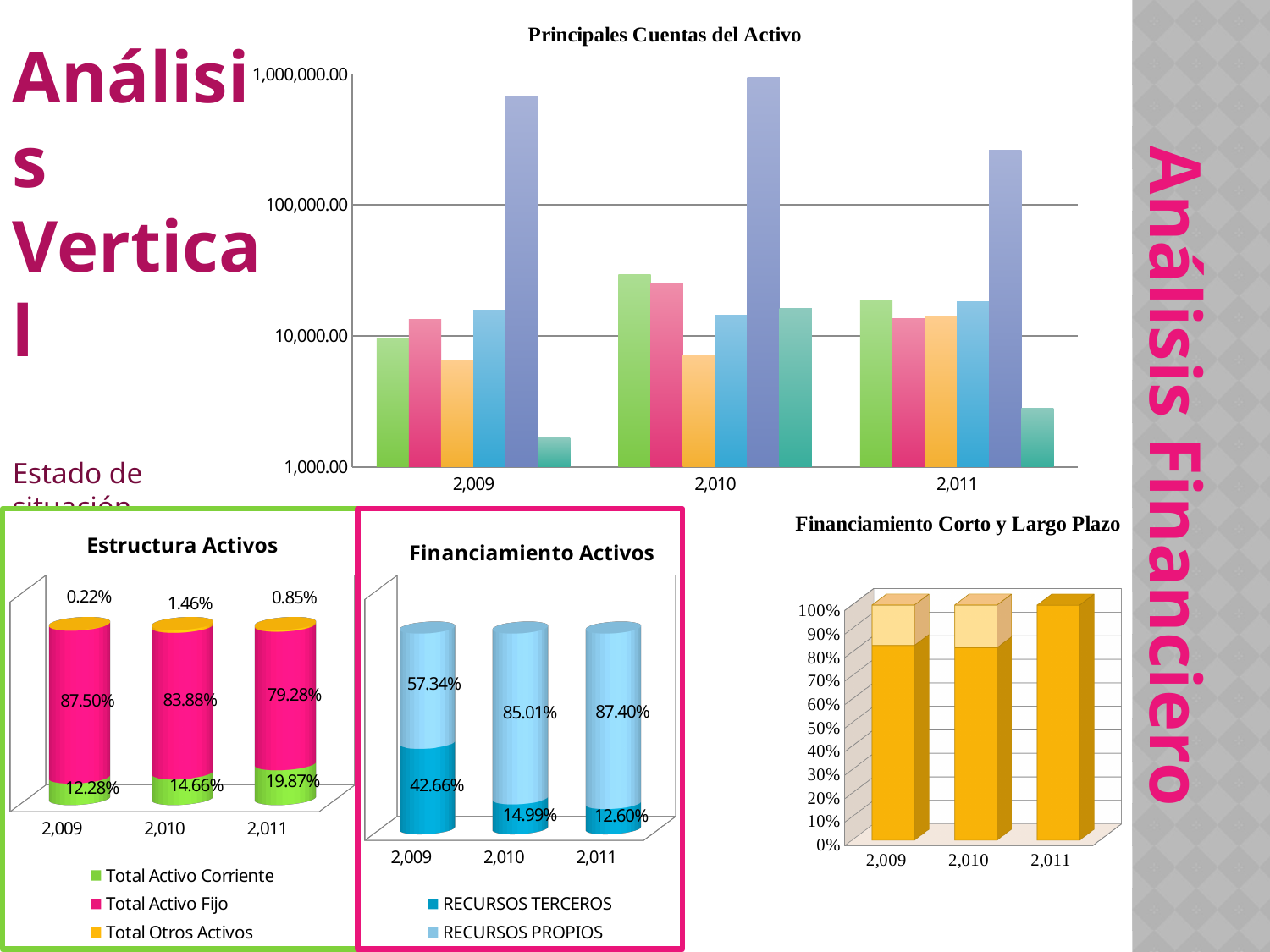
In the Financiamiento Activos chart, what is the difference between RECURSOS PROPIOS and RECURSOS TERCEROS in 2,011? 74.80% In the Financiamiento Corto y Largo Plazo chart, is the bottom (dark orange) segment for 2,009 greater or less than 50%? greater In the Financiamiento Activos chart, which is larger in 2,009: RECURSOS TERCEROS or RECURSOS PROPIOS? RECURSOS PROPIOS How many years are shown on the x axis of the Principales Cuentas del Activo chart? 3 In the Estructura Activos chart, which year has the highest value for Total Otros Activos? 2,010 In the Financiamiento Activos chart, what is the value of RECURSOS TERCEROS for 2,010? 14.99% In the Financiamiento Activos chart, which year has the lowest value for RECURSOS PROPIOS? 2,009 In the Estructura Activos chart, does Total Activo Fijo rise or fall from 2,009 to 2,011? fall What kind of chart is Financiamiento Corto y Largo Plazo? stacked bar chart In the Estructura Activos chart, how many series does the legend list? 3 In the Estructura Activos chart, what is the value of Total Activo Corriente for 2,011? 19.87% In the Estructura Activos chart, what is the value of Total Activo Fijo for 2,009? 87.50%